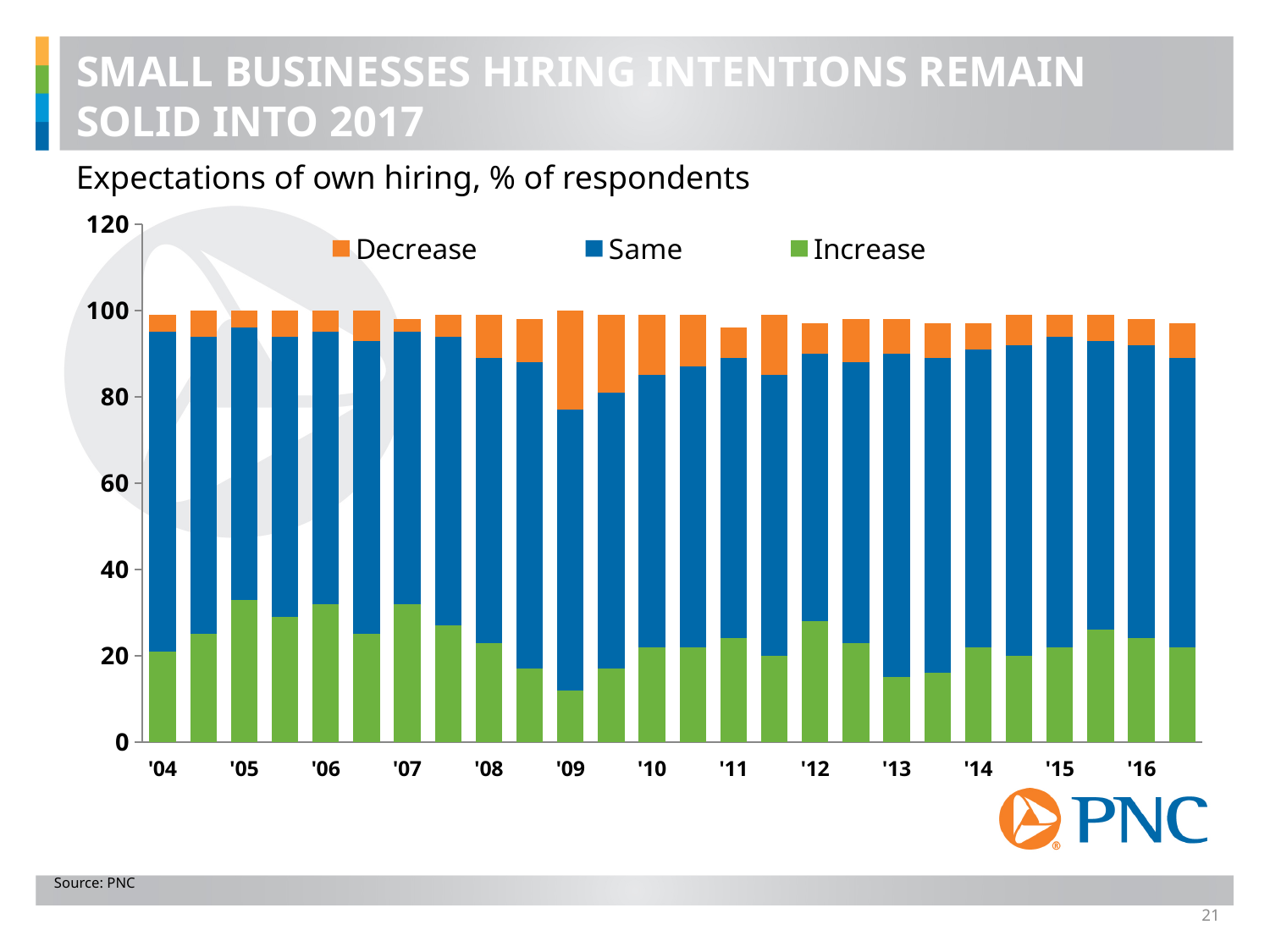
Is the top of the Same segment for the first bar of '09 greater or less than 80? less Is the Increase value for the first bar of '09 greater or less than 20? less Which year has the smallest Increase segment? '09 What are the three series named in the legend? Decrease, Same, Increase How many years are labelled on the x axis? 13 Does the Increase segment rise or fall from '09 to '12? Rise Which has the larger Increase segment, the first bar of '05 or the first bar of '09? '05 How many series does the legend list? 3 Is the Increase value for the first bar of '05 greater or less than 20? greater What kind of chart is shown on the slide? Stacked bar chart Which year has the largest Decrease segment? '09 What is the subtitle describing the chart's data? Expectations of own hiring, % of respondents